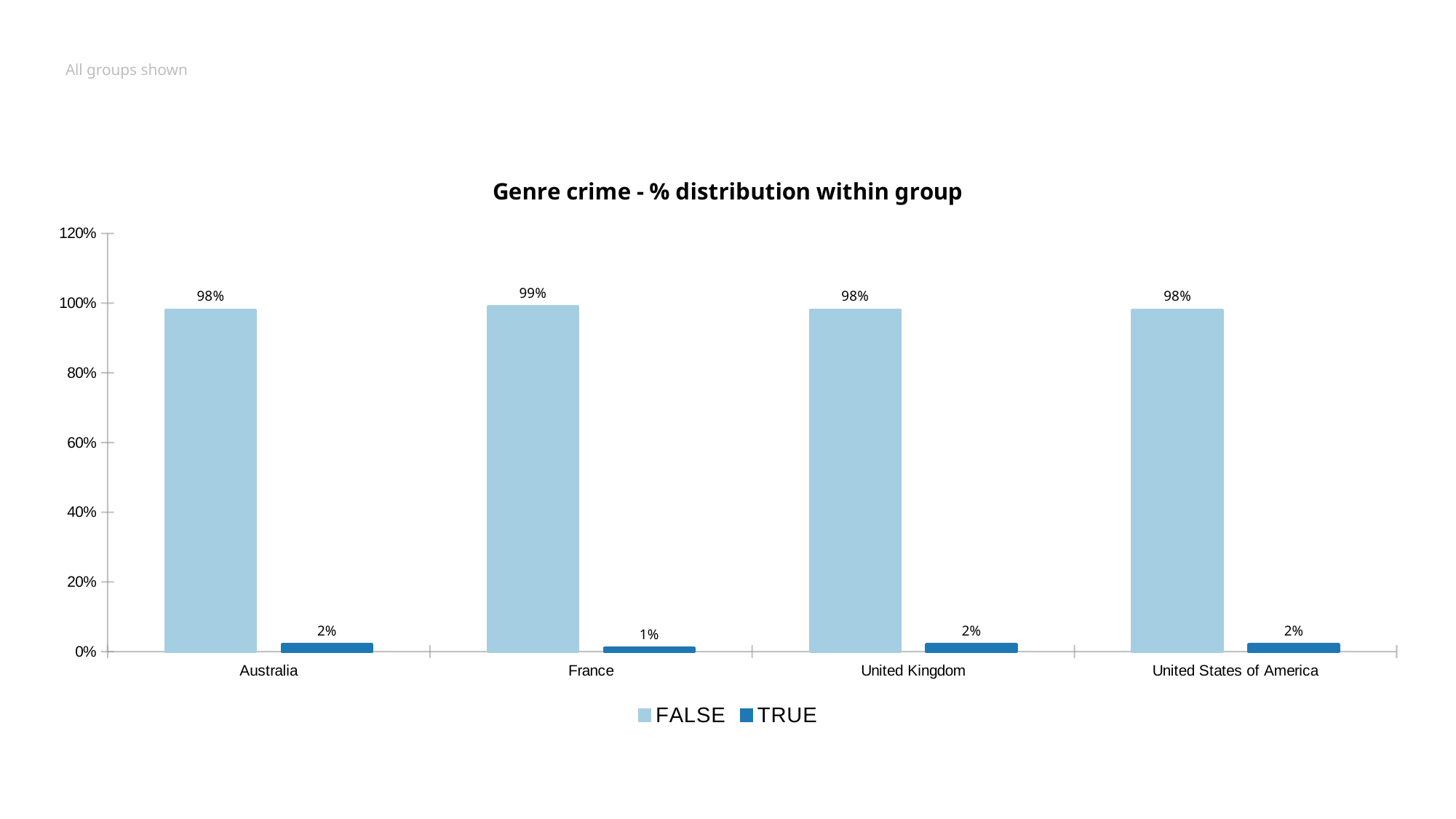
What is the title of the chart? Genre crime - % distribution within group What is the difference between the FALSE and TRUE values for United States of America? 96% Which is larger for France: the FALSE value or the TRUE value? FALSE What is the TRUE value for Australia? 2% What kind of chart is shown on the slide? Bar chart What is the TRUE value for France? 1% How many countries are shown on the x axis? 4 How many series does the legend list? 2 What is the FALSE value for United Kingdom? 98% What is the FALSE value for France? 99% Which country has the highest FALSE value? France Which country has the lowest TRUE value? France